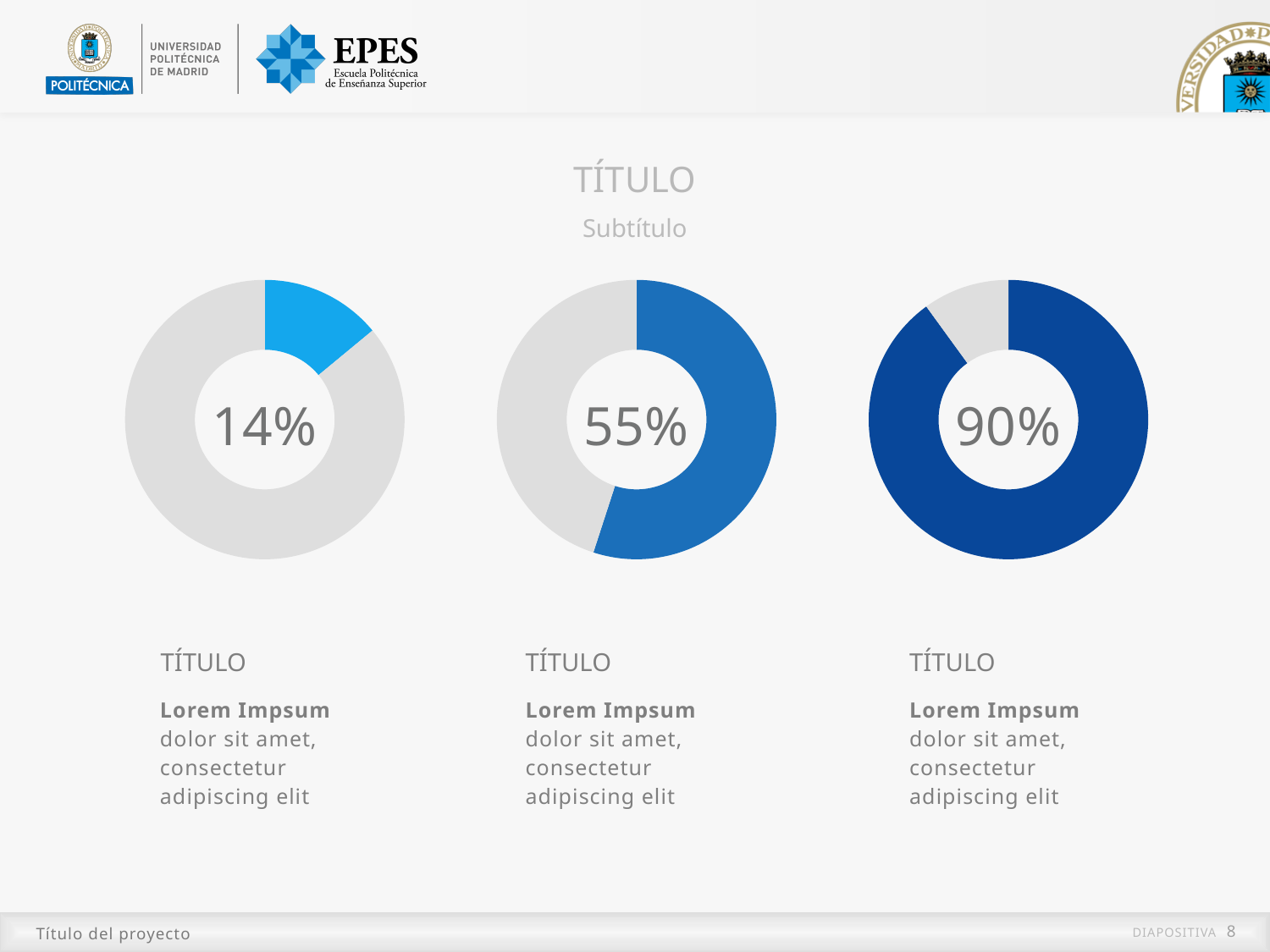
Which shows a larger percentage, the middle donut chart or the right donut chart? right What is the difference between the percentage in the middle donut chart and the percentage in the left donut chart? 41% Is the percentage shown in the middle donut chart greater or less than 50%? greater Do the percentages increase or decrease going from the left chart to the right chart? increase Which of the three donut charts shows the lowest percentage: left, middle or right? left What percentage is shown in the centre of the left donut chart? 14% What percentage is shown in the centre of the right donut chart? 90% How many donut charts are on the slide? 3 What kind of chart is used to display the three percentages on the slide? donut chart What percentage is shown in the centre of the middle donut chart? 55% Which of the three donut charts shows the highest percentage: left, middle or right? right What is the difference between the percentage in the right donut chart and the percentage in the left donut chart? 76%